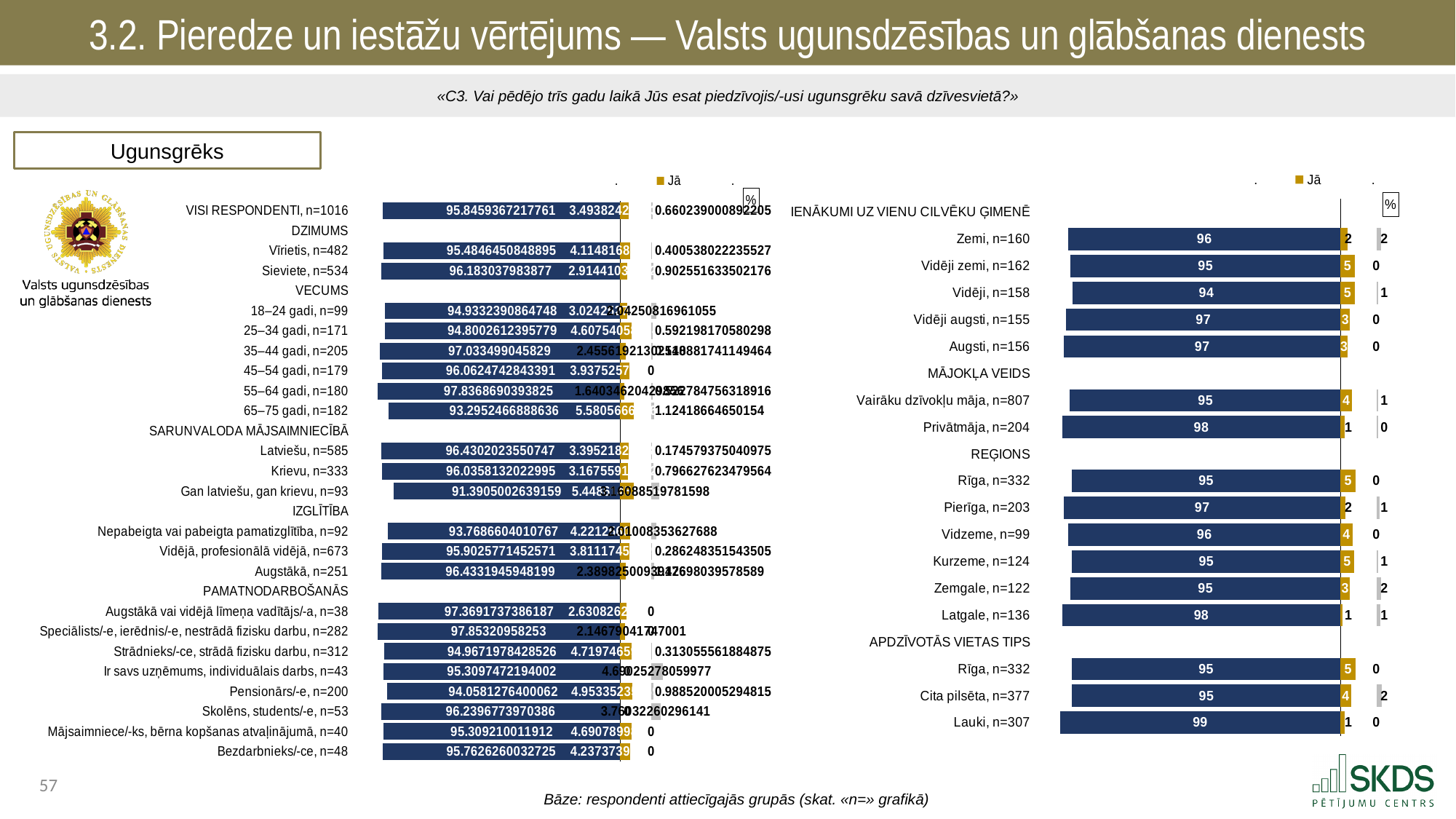
How many categories (rows with bars) are plotted in the left-hand chart? 23 In the right-hand chart, what is the value of the dark blue bar for Privātmāja, n=204? 98 In the right-hand chart, what is the value of the dark blue bar for Lauki, n=307? 99 In the right-hand chart, what is the difference between the dark blue bar values for Lauki, n=307 and Vidēji, n=158? 5 In the right-hand chart, which has the larger dark blue bar value: Privātmāja, n=204 or Vairāku dzīvokļu māja, n=807? Privātmāja, n=204 What kind of chart is used on this slide? Bar chart In the right-hand chart, which category has the highest dark blue bar value? Lauki, n=307 In the right-hand chart, what is the value of the gold 'Jā' bar for Rīga, n=332 under REĢIONS? 5 In the right-hand chart, which category has the lowest dark blue bar value? Vidēji, n=158 What is the only series name shown in the legend of each chart? Jā How many categories (rows with bars) are plotted in the right-hand chart? 16 In the right-hand chart, what is the total of the three values shown for Zemi, n=160? 100